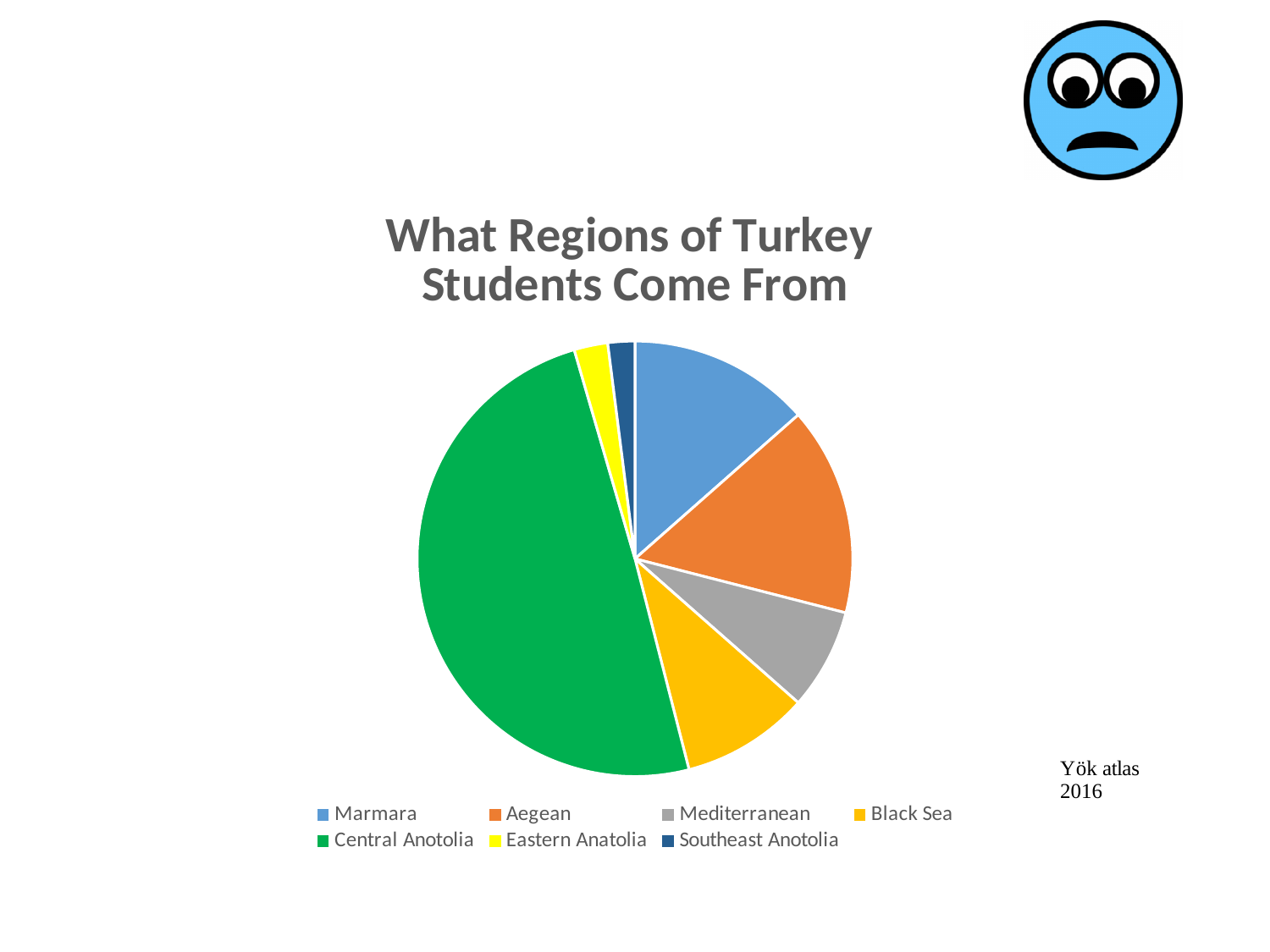
Which region has the largest share of the pie? Central Anotolia Which slice is larger, Central Anotolia or Marmara? Central Anotolia Which slice is larger, Aegean or Marmara? Aegean What colour is the Central Anotolia slice in the pie chart? green How many regions (slices) does the pie chart show? 7 What is the title of the chart? What Regions of Turkey Students Come From Which slice is larger, Black Sea or Eastern Anatolia? Black Sea What kind of chart is shown on the slide? pie chart